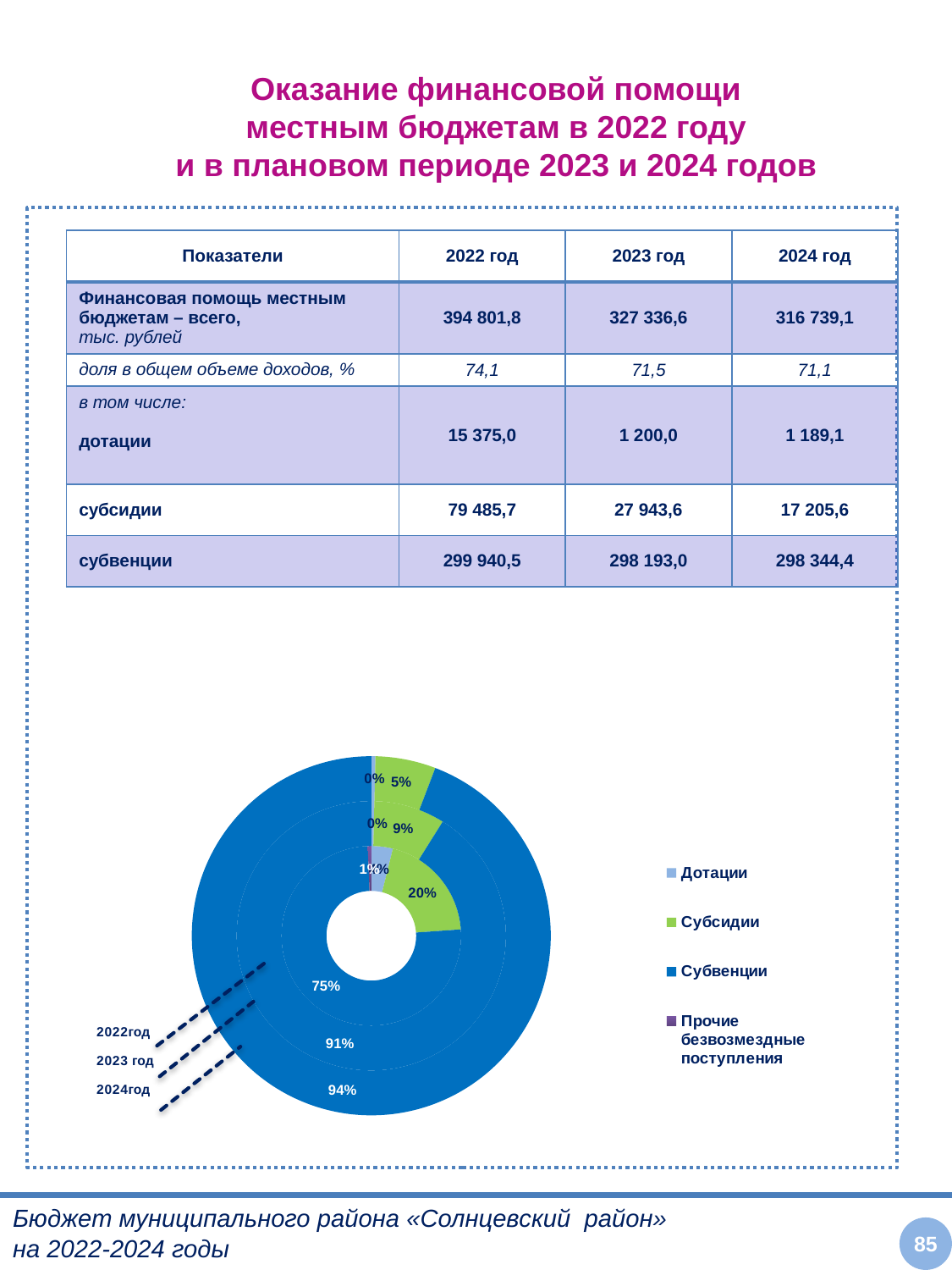
What share do Субвенции have in the 2022 ring of the chart? 75% Which category has the largest share in the 2024 ring of the chart? Субвенции What kind of chart is shown on the slide? doughnut chart What share do Субсидии have in the 2024 ring of the chart? 5% How many entries does the chart legend list? 4 How many rings (years) does the doughnut chart have? 3 Does the share of Субсидии rise or fall from the 2022 ring to the 2024 ring? fall Which legend entry is shown in green on the chart? Субсидии What share do Субвенции have in the 2024 ring of the chart? 94%